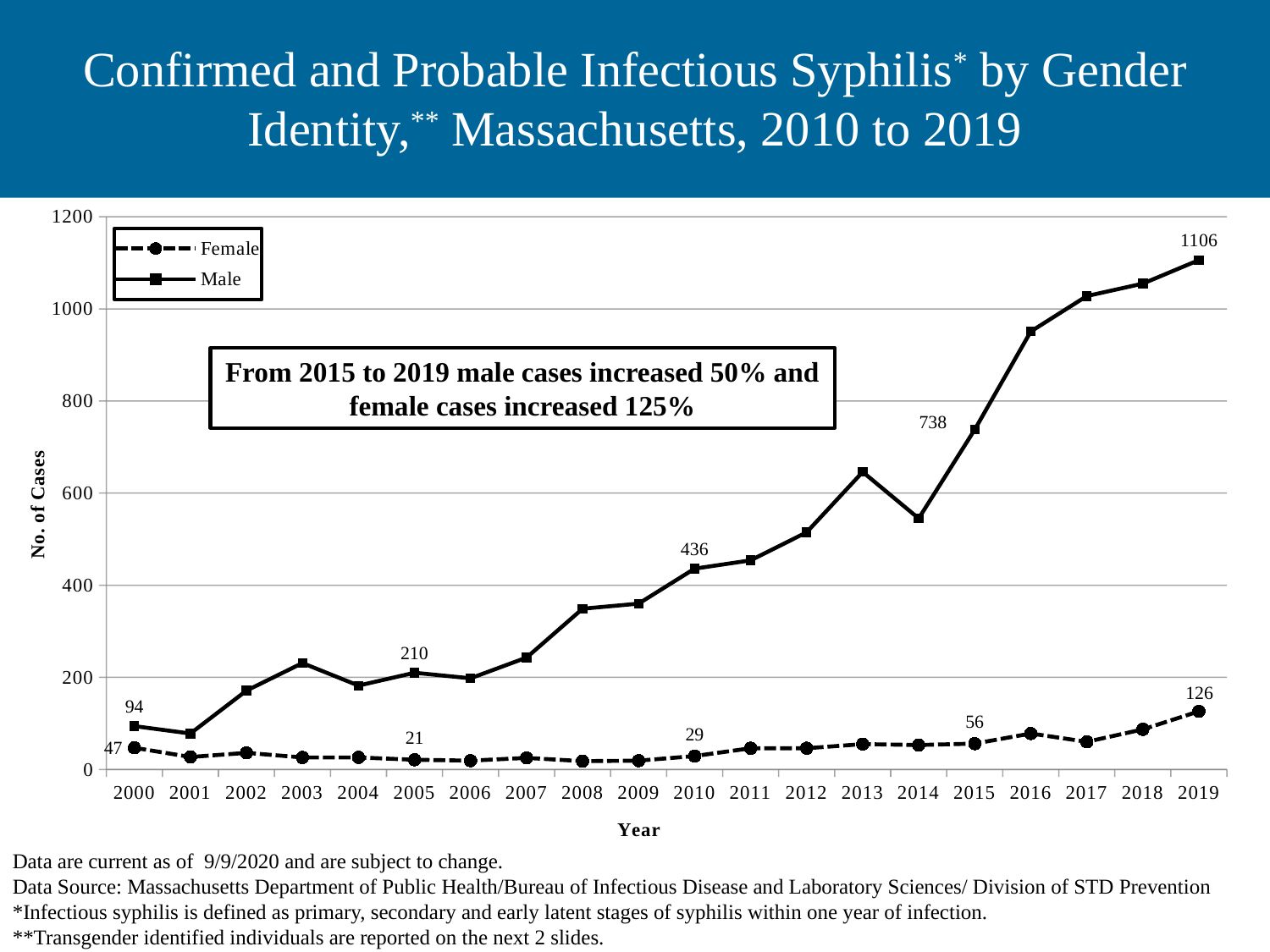
Which year has the highest number of male cases? 2019 Is the number of male cases in 2016 greater or less than 800? greater What is the difference between male and female cases in 2019? 980 What is the number of male cases in 2010? 436 What type of chart is shown on the slide? Line chart What is the number of female cases in 2005? 21 What is the number of female cases in 2015? 56 How many series does the legend list? 2 Which is larger, the number of female cases in 2000 or in 2005? 2000 How many years are shown on the x axis? 20 What is the difference between male cases in 2015 and male cases in 2010? 302 What is the number of male cases in 2019? 1106